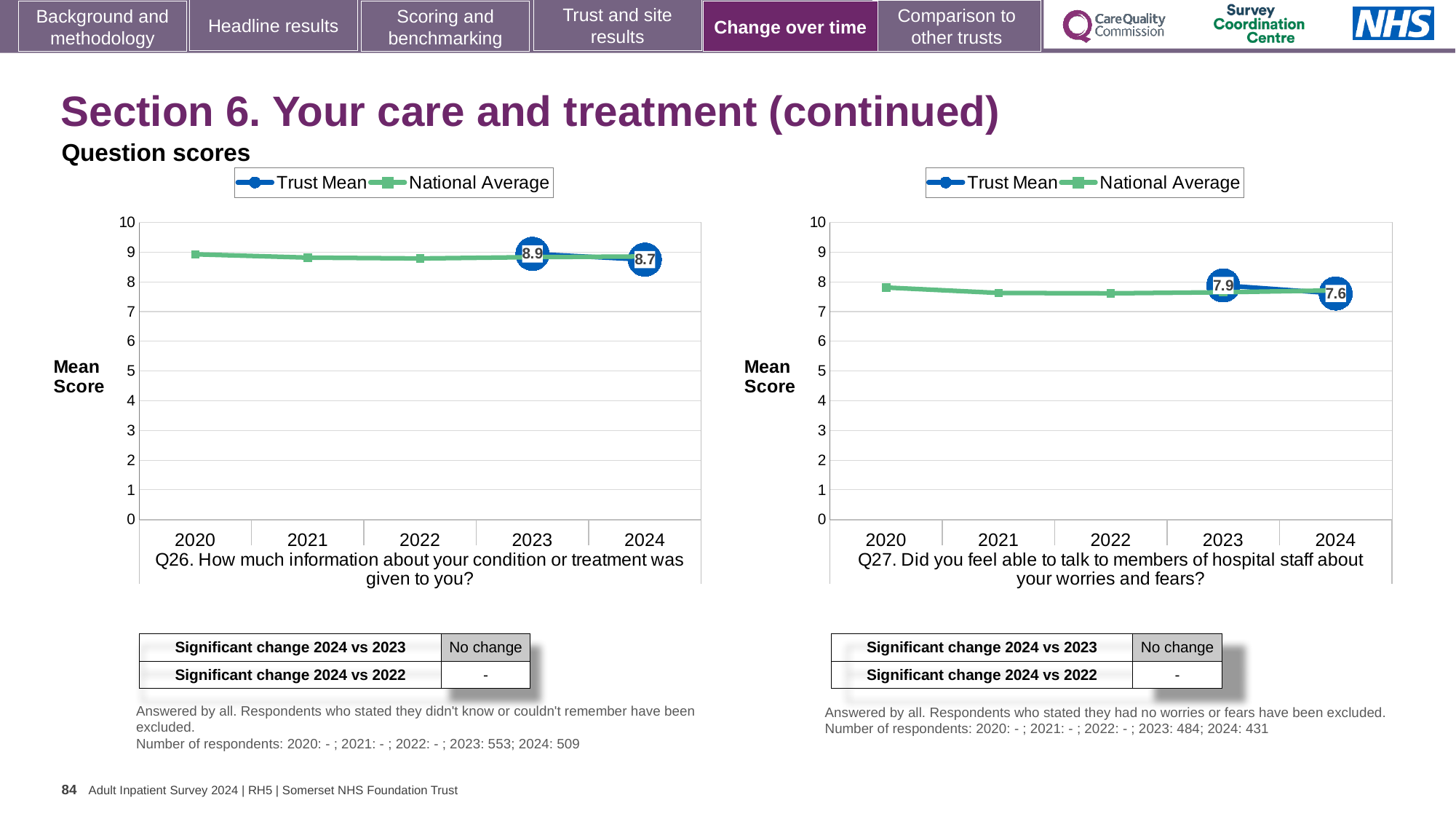
What kind of chart is used for Q26 (left)? Line chart In the Q27 chart (right), what is the Trust Mean score for 2023? 7.9 In the Q27 chart (right), is the National Average for 2021 greater or less than 8? less In the Q27 chart (right), what is the Trust Mean score for 2024? 7.6 How many years are shown on the x axis of the Q26 chart (left)? 5 In the Q26 chart (left), what is the Trust Mean score for 2023? 8.9 In the Q27 chart (right), which year has the higher Trust Mean, 2023 or 2024? 2023 In the Q27 chart (right), what is the difference between the Trust Mean in 2023 and 2024? 0.3 In the Q26 chart (left), what is the Trust Mean score for 2024? 8.7 How many series does the legend of the Q27 chart (right) list? 2 In the Q26 chart (left), by how much did the Trust Mean change from 2023 to 2024? 0.2 In the Q26 chart (left), is the National Average for 2020 greater or less than 8? greater